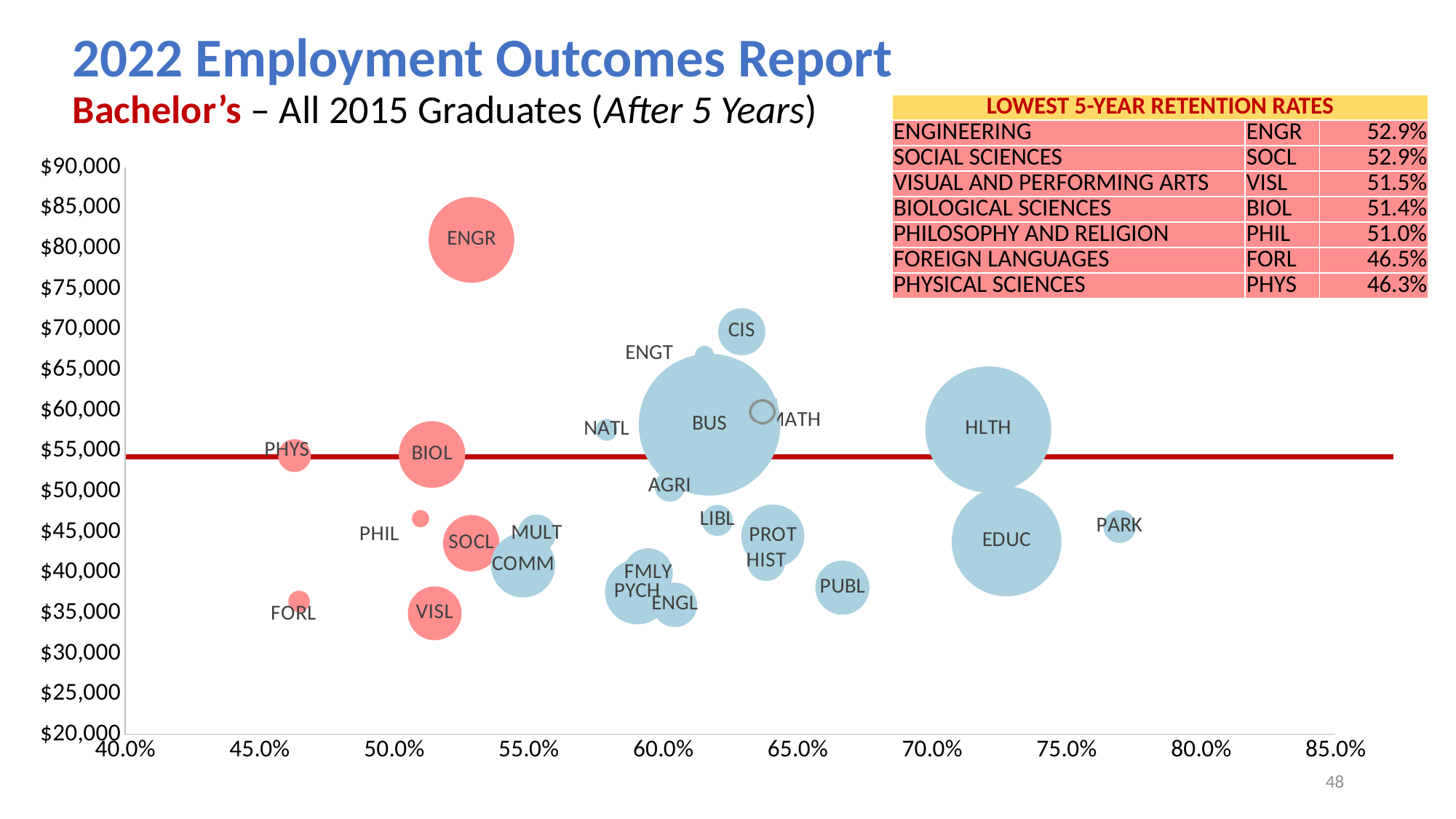
Is the salary value for ENGR greater or less than $75,000? greater Which bubble is positioned highest on the salary (vertical) axis? ENGR Is the salary value for EDUC greater or less than $50,000? less According to the table, what is the 5-year retention rate for FORL (Foreign Languages)? 46.5% According to the table, which program has the lowest 5-year retention rate? PHYS (Physical Sciences), 46.3% What is the difference between the retention rates of ENGR and PHYS shown in the table? 6.6 percentage points Which bubble is positioned furthest to the right on the retention-rate (horizontal) axis? PARK Is the salary value for CIS greater or less than $65,000? greater What kind of chart is shown on the slide? bubble chart How many bubbles on the chart are coloured red? 7